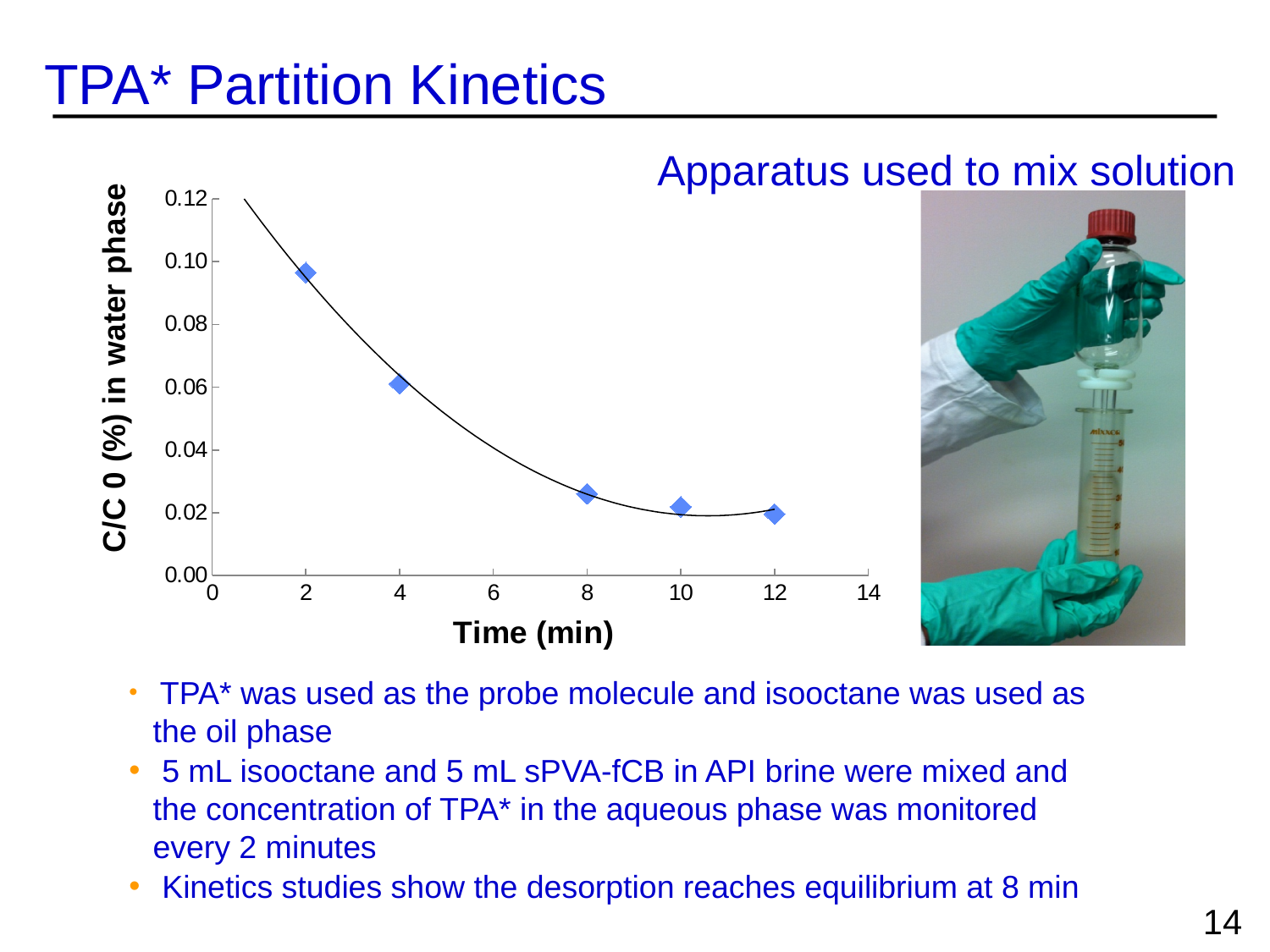
What is the title of the y axis? C/C 0 (%) in water phase Is the value at 2 min greater or less than 0.08? greater Is the value at 12 min greater or less than 0.04? less Is the value at 4 min greater or less than 0.04? greater Do the plotted values rise or fall as time increases along the x axis? fall What is the title of the x axis? Time (min) What kind of chart is shown on the slide? scatter plot Which is larger, the value at 2 min or the value at 4 min? 2 min At which time (in minutes) is the plotted value highest? 2 How many data points are plotted on the chart? 5